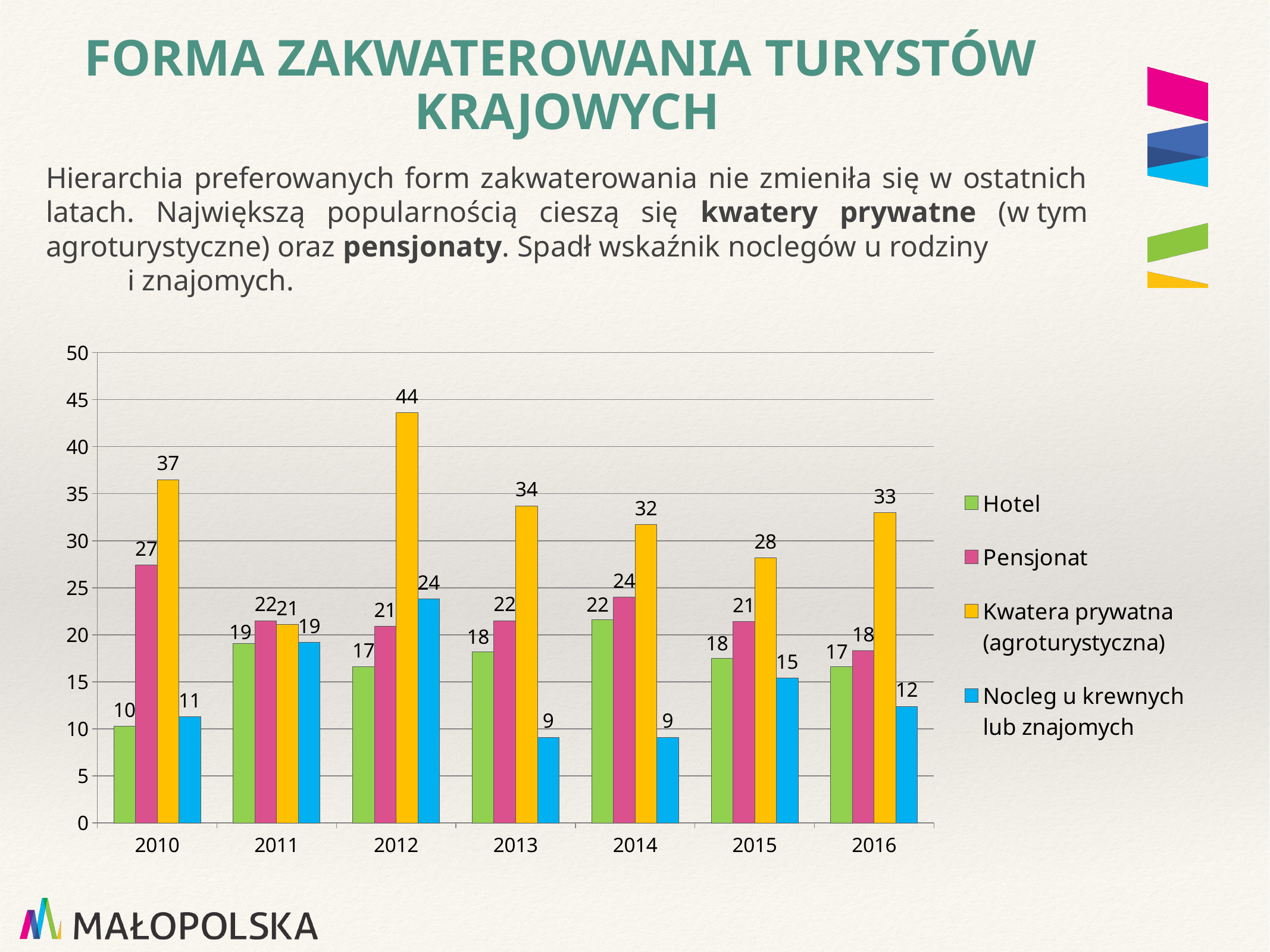
Which colour represents Nocleg u krewnych lub znajomych in the legend? Blue How many series does the legend list? 4 What is the value for Hotel in 2010? 10 What is the value for Nocleg u krewnych lub znajomych in 2015? 15 What is the difference between the Kwatera prywatna (agroturystyczna) value and the Hotel value in 2016? 16 Which is larger in 2011: the value for Pensjonat or the value for Kwatera prywatna (agroturystyczna)? Pensjonat In which year is the value for Kwatera prywatna (agroturystyczna) highest? 2012 What is the value for Pensjonat in 2014? 24 In which year is the value for Hotel lowest? 2010 What kind of chart is shown on the slide? Bar chart How many years are shown on the x axis? 7 What is the value for Kwatera prywatna (agroturystyczna) in 2012? 44